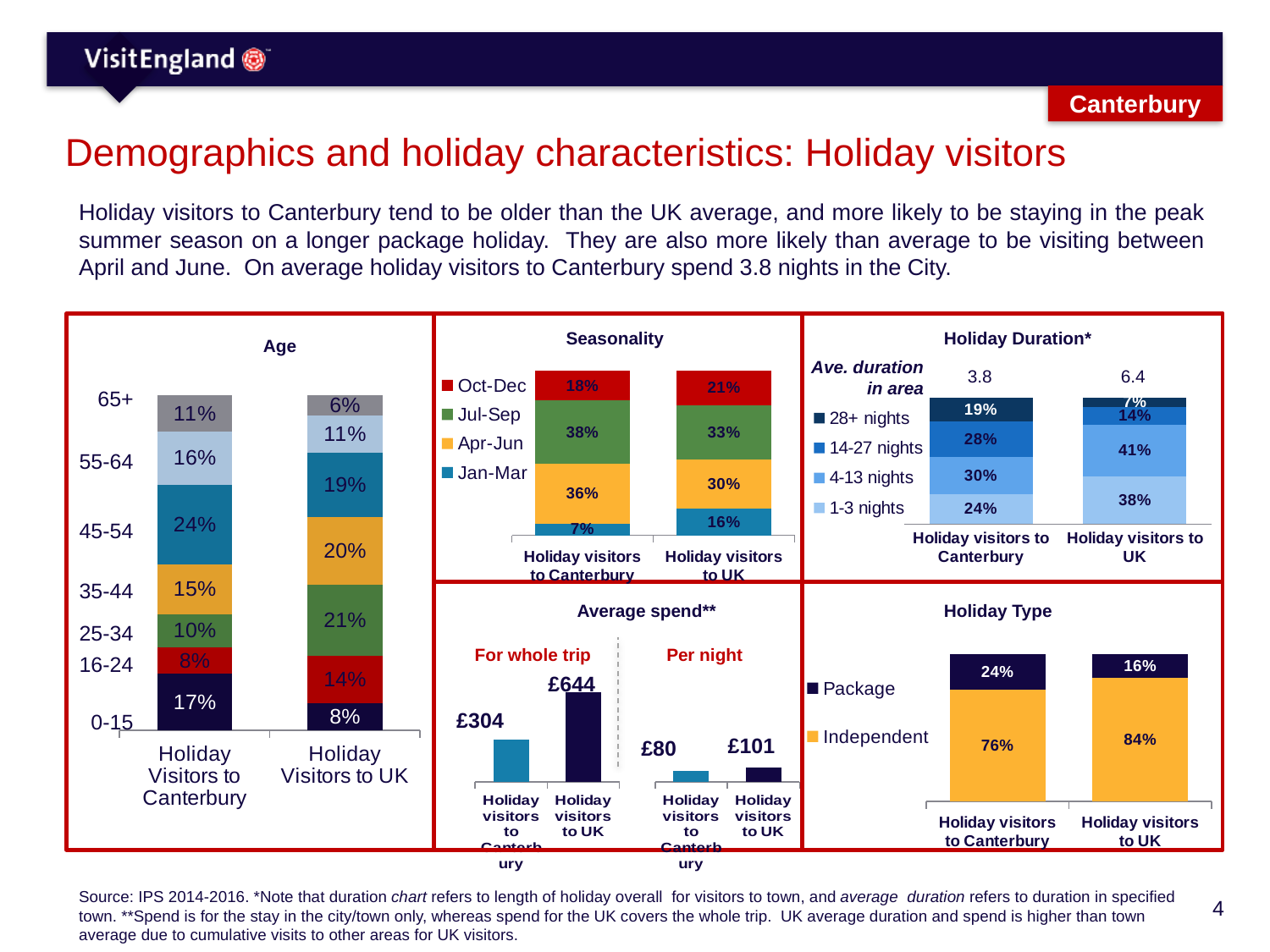
In the Holiday Type chart, what share of holiday visitors to Canterbury are on a package holiday? 24% In the Average spend chart, what is the difference in per night spend between holiday visitors to the UK and holiday visitors to Canterbury? £21 In the Seasonality chart, what share of holiday visitors to the UK visit in Jan-Mar? 16% In the Age chart, which age group is the largest among holiday visitors to the UK? 25-34 In the Holiday Duration chart, what percentage of holiday visitors to the UK stay 1-3 nights? 38% In the Age chart, what percentage of holiday visitors to Canterbury are aged 45-54? 24% In the Holiday Type chart, which group has the larger Independent share, holiday visitors to Canterbury or holiday visitors to the UK? Holiday visitors to UK In the Holiday Duration chart, what is the average duration in area for holiday visitors to Canterbury? 3.8 How many series does the legend of the Seasonality chart list? 4 What kind of chart is the Holiday Duration chart? Stacked bar chart In the Average spend chart, what is the spend for the whole trip for holiday visitors to the UK? £644 In the Seasonality chart, what share of holiday visitors to Canterbury visit in Jul-Sep? 38%